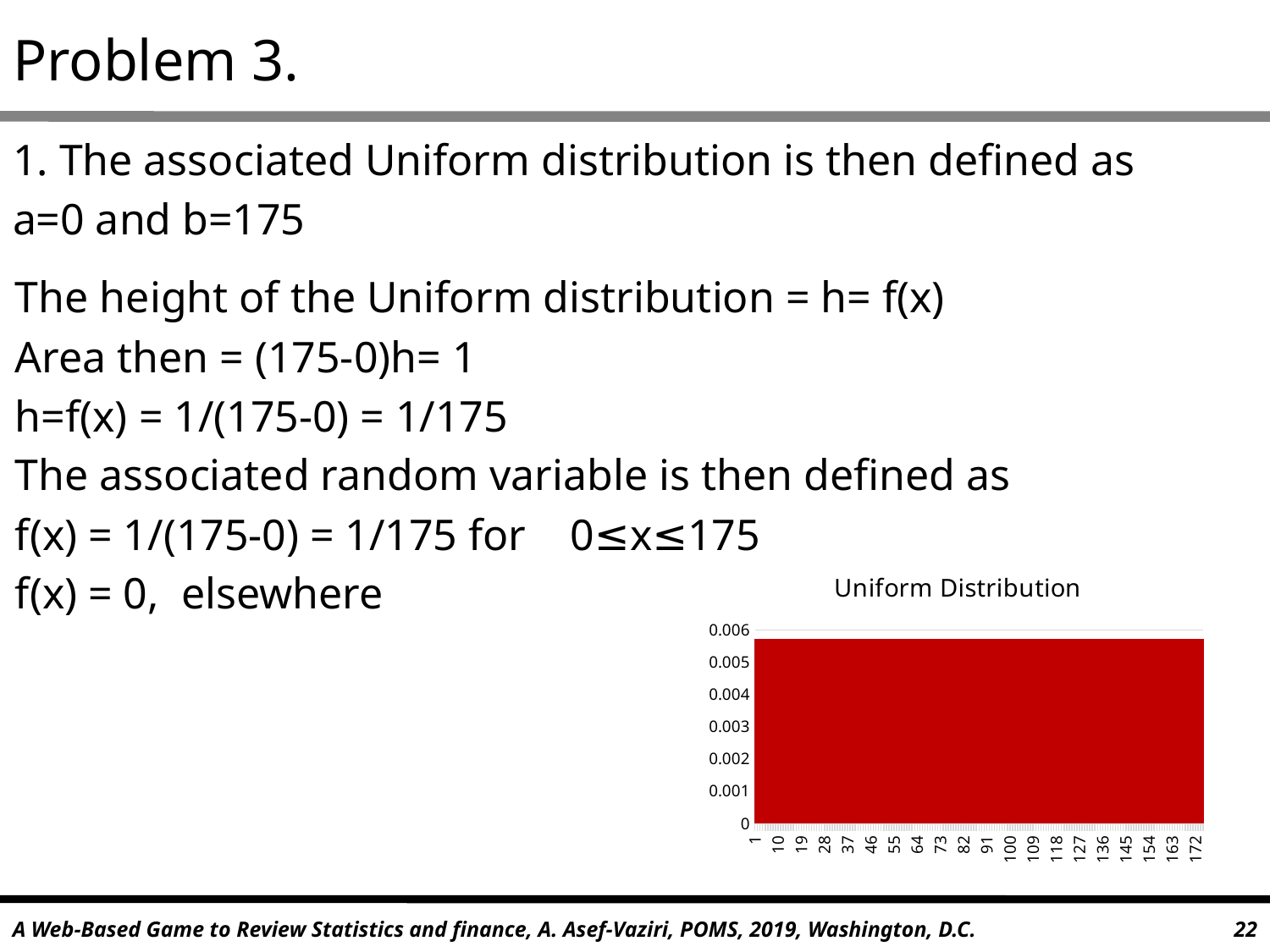
What kind of chart is shown on the slide? area chart Is the value plotted at x = 100 greater or less than 0.005? greater What is the highest tick value shown on the y axis? 0.006 What is the first label shown on the x axis? 1 What is the last label shown on the x axis? 172 Is the value plotted at x = 55 larger than, smaller than, or the same as the value at x = 145? the same What is the title of the chart? Uniform Distribution Do the plotted values rise, fall, or stay flat as x increases along the x axis? stay flat Is the value plotted at x = 172 greater or less than 0.003? greater